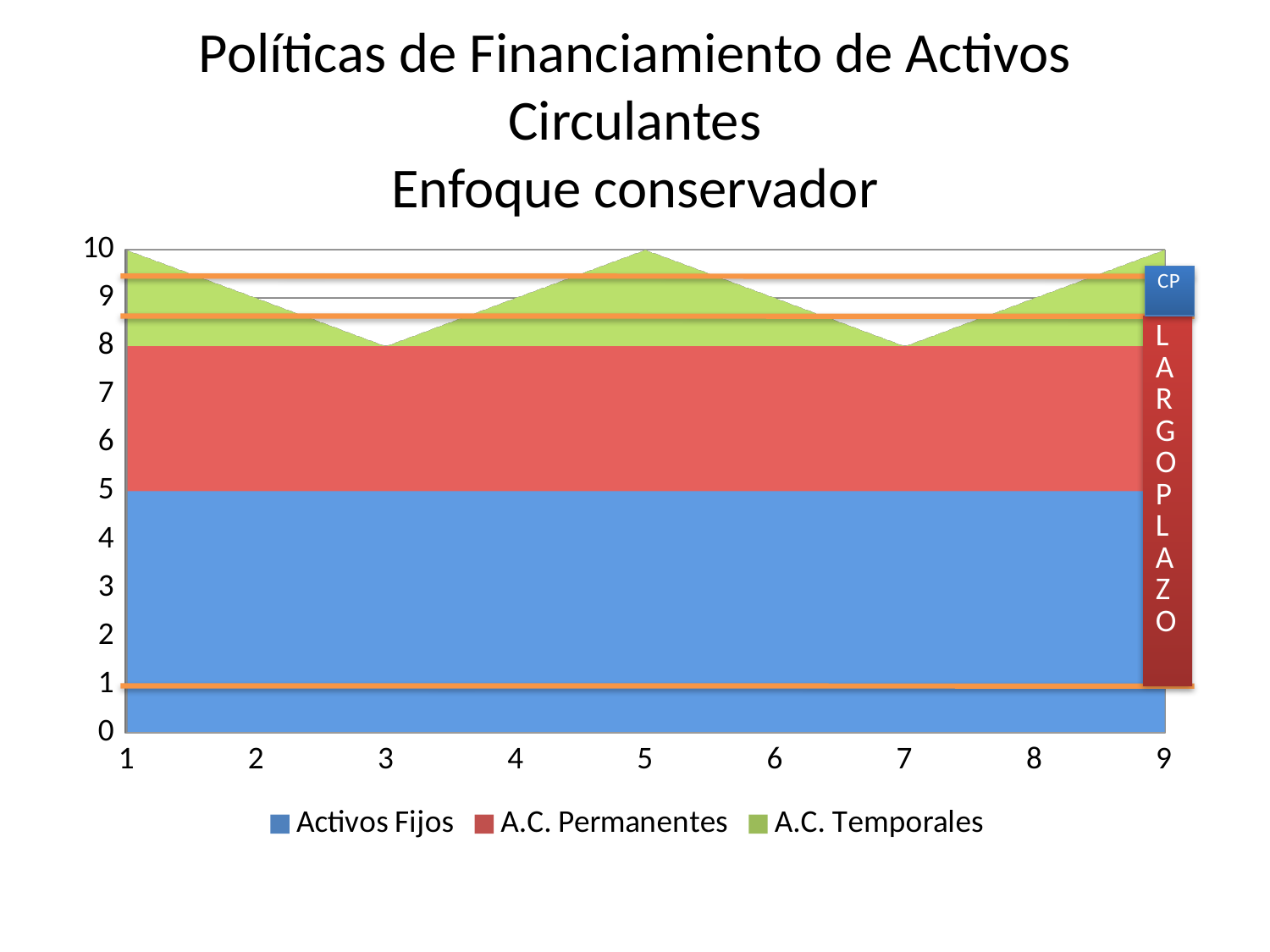
What type of chart is shown on the slide? Stacked area chart Which series are listed in the legend? Activos Fijos, A.C. Permanentes, A.C. Temporales What is the total height of the stacked areas at x = 3? 8 What value on the y axis does the top of the Activos Fijos area reach? 5 How many points are shown along the x axis? 9 Is the total stacked value at x = 4 greater or less than 8? greater Which series forms the bottom layer of the stacked area? Activos Fijos What is the total height of the stacked areas at x = 5? 10 How many series does the legend list? 3 Is the total stacked value at x = 2 greater or less than 10? less Which is larger, the total stacked value at x = 3 or at x = 5? x = 5 Does the top of the A.C. Temporales area rise or fall from x = 1 to x = 3? fall